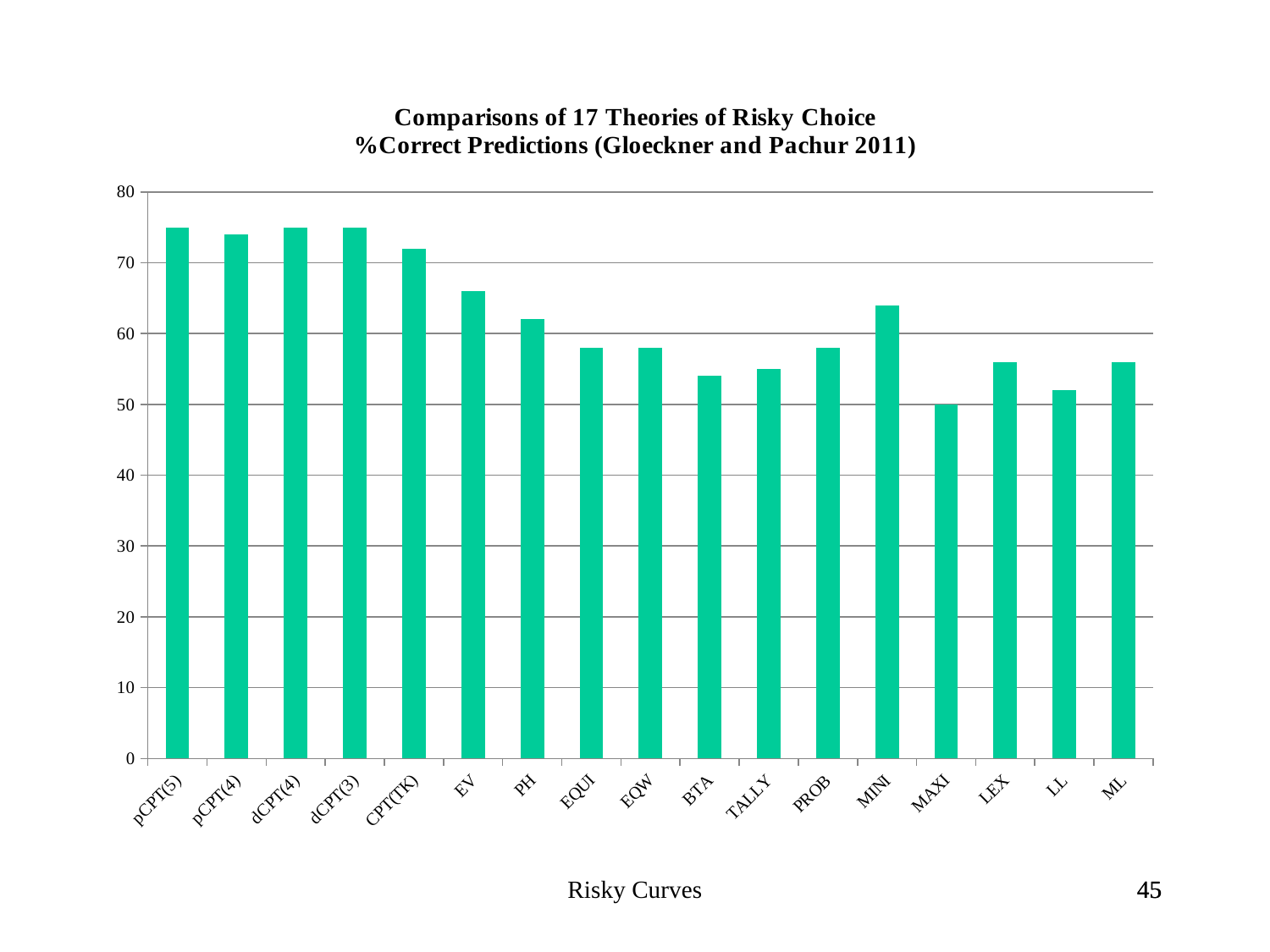
Moving along the x axis from CPT(TK) to BTA, do the values rise or fall? fall How many theories (categories) are plotted on the x axis? 17 Is the value for EV greater or less than 60? greater Is the value for ML greater or less than 60? less Which has a higher value, EV or PH? EV Which has a higher value, MINI or MAXI? MINI Is the value for MINI greater or less than 60? greater What kind of chart is shown on the slide? bar chart Which theory has the lowest percentage of correct predictions? MAXI Which study is cited in the chart title as the source of the data? Gloeckner and Pachur 2011